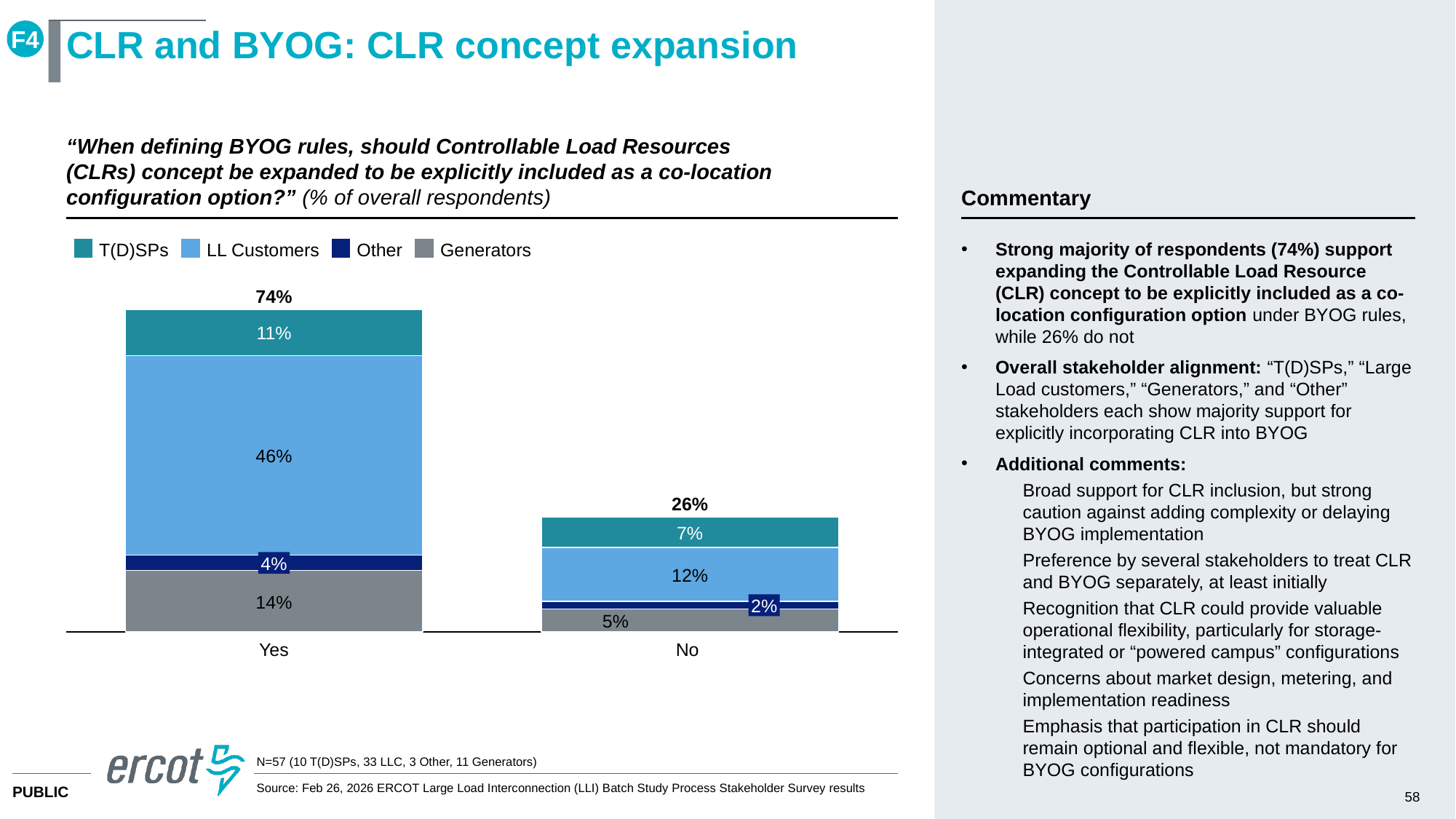
What kind of chart is shown on the slide? Stacked bar chart What is the difference between the LL Customers values in the Yes and No bars? 34% How many series does the legend list? 4 Which response category has the higher total, Yes or No? Yes What is the difference between the Yes total and the No total? 48% What is the value for Generators in the Yes bar? 14% What is the total percentage shown for the No bar? 26% What is the value for T(D)SPs in the No bar? 7% What is the value for LL Customers in the Yes bar? 46% How many response categories are shown on the x axis? 2 What is the value for Other in the No bar? 2% What is the total percentage shown for the Yes bar? 74%